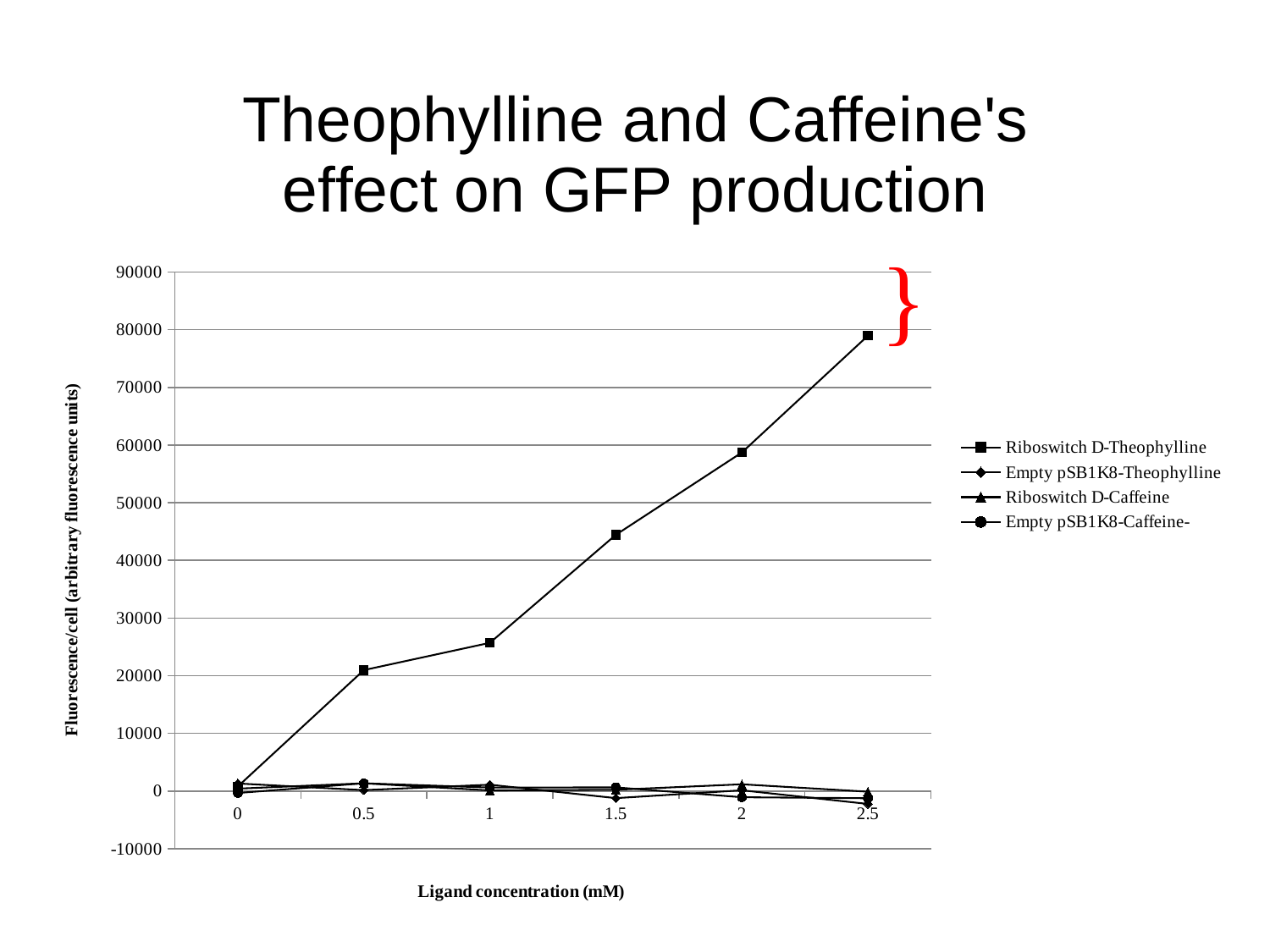
What is the label of the x axis? Ligand concentration (mM) Which is larger at 2 mM: Riboswitch D-Theophylline or Riboswitch D-Caffeine? Riboswitch D-Theophylline How many ligand concentration points are plotted along the x axis? 6 Does the Riboswitch D-Theophylline series rise or fall as ligand concentration increases? rise Is the value for Riboswitch D-Theophylline at 2.5 mM greater or less than 70000? greater Is the value for Riboswitch D-Theophylline at 0.5 mM greater or less than 10000? greater Is the value for Riboswitch D-Theophylline at 1.5 mM greater or less than 40000? greater What kind of chart is shown on the slide? line chart Which series has the highest fluorescence at a ligand concentration of 2.5 mM? Riboswitch D-Theophylline How many series does the legend list? 4